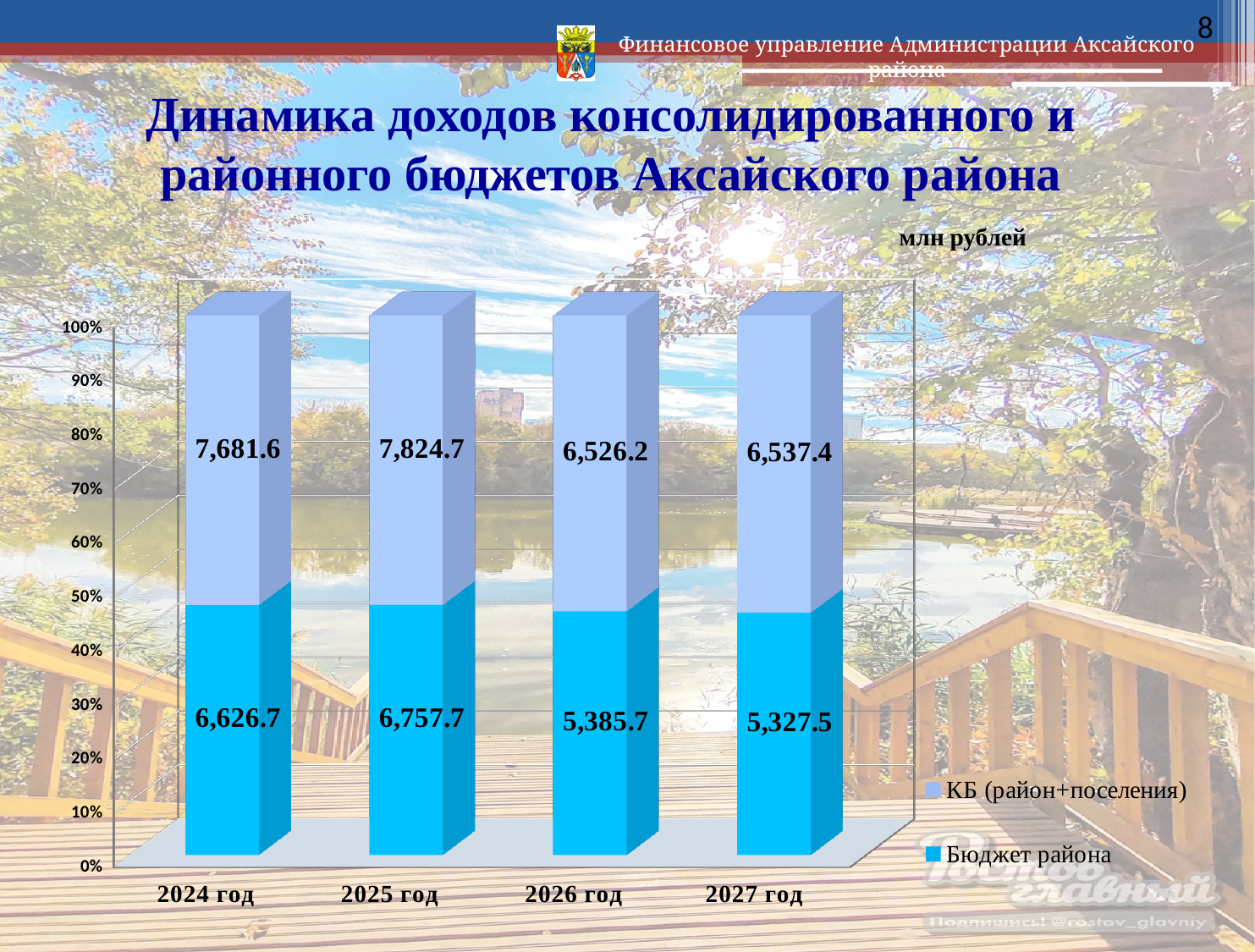
What is the value for КБ (район+поселения) in 2027 год? 6,537.4 How many series does the legend list? 2 What is the value for Бюджет района in 2026 год? 5,385.7 In which year is the value for КБ (район+поселения) the highest? 2025 год In which year is the value for Бюджет района the lowest? 2027 год What kind of chart is shown on the slide? stacked bar chart How many years are shown on the x axis? 4 What is the difference between КБ (район+поселения) and Бюджет района in 2025 год? 1,067.0 Does the value for Бюджет района rise or fall from 2025 год to 2027 год? fall Which is larger: Бюджет района in 2024 год or in 2025 год? 2025 год By how much does КБ (район+поселения) in 2025 год exceed КБ (район+поселения) in 2024 год? 143.1 What is the value for КБ (район+поселения) in 2024 год? 7,681.6